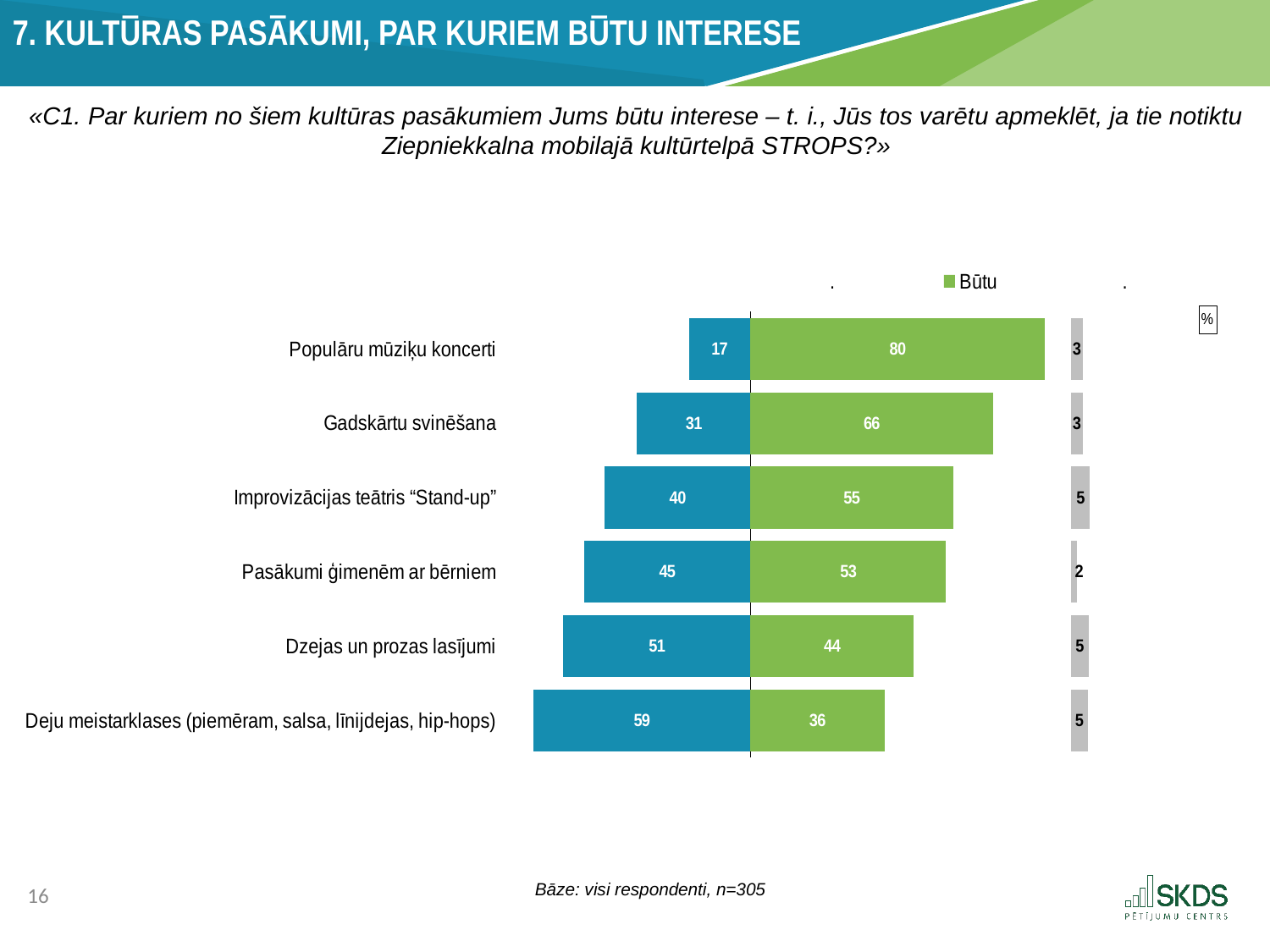
How many cultural event categories are listed in the chart? 6 What is the grey bar value for "Pasākumi ģimenēm ar bērniem"? 2 What is the base (Bāze) stated below the chart? visi respondenti, n=305 What kind of chart is shown on the slide? bar chart What is the "Būtu" (green) value for "Dzejas un prozas lasījumi"? 44 Do the "Būtu" (green) values rise or fall going down the list of categories from top to bottom? fall What is the "Būtu" (green) value for "Populāru mūziķu koncerti"? 80 What is the blue bar value for "Deju meistarklases (piemēram, salsa, līnijdejas, hip-hops)"? 59 Which is larger for "Pasākumi ģimenēm ar bērniem": the blue bar value or the "Būtu" (green) value? Būtu (green), 53 Which category has the lowest "Būtu" (green) value? Deju meistarklases (piemēram, salsa, līnijdejas, hip-hops) Which category has the highest "Būtu" (green) value? Populāru mūziķu koncerti What is the difference between the "Būtu" (green) values for "Gadskārtu svinēšana" and "Improvizācijas teātris “Stand-up”"? 11